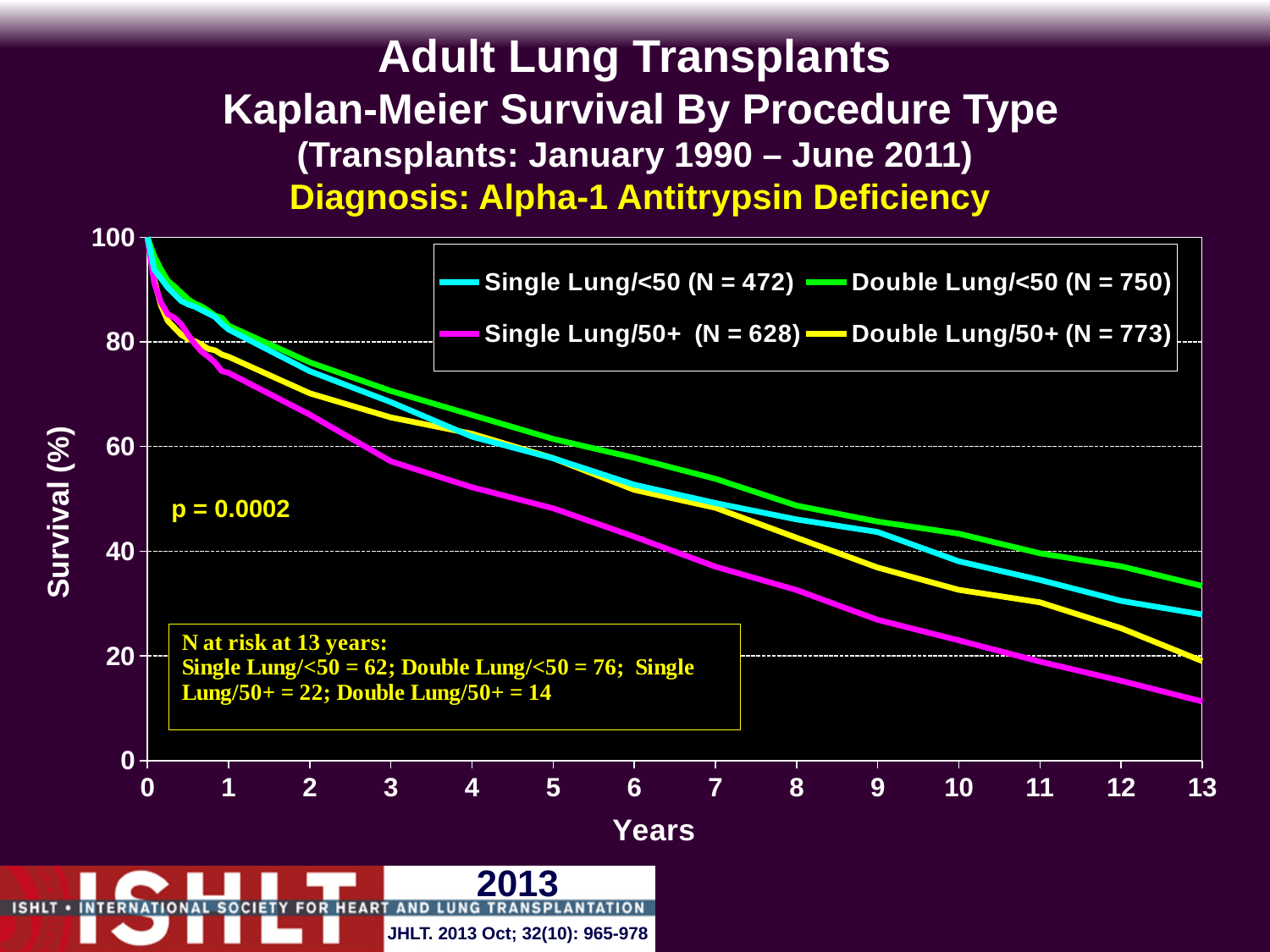
According to the text box, what is the N at risk at 13 years for Double Lung/<50? 76 Do the survival curves rise or fall as years increase? fall Which procedure group has the lowest survival at 13 years? Single Lung/50+ Which procedure group has the highest survival at 13 years? Double Lung/<50 Is the survival for Double Lung/<50 at 13 years greater or less than 20? greater At 5 years, which group has higher survival: Double Lung/<50 or Single Lung/50+? Double Lung/<50 What kind of chart is shown on the slide? line chart Is the survival for Single Lung/50+ at 13 years greater or less than 20? less What is the N for the Double Lung/50+ group shown in the legend? 773 How many series does the legend list? 4 Is the survival for Single Lung/50+ at 5 years greater or less than 60? less What is the p-value shown on the chart? p = 0.0002